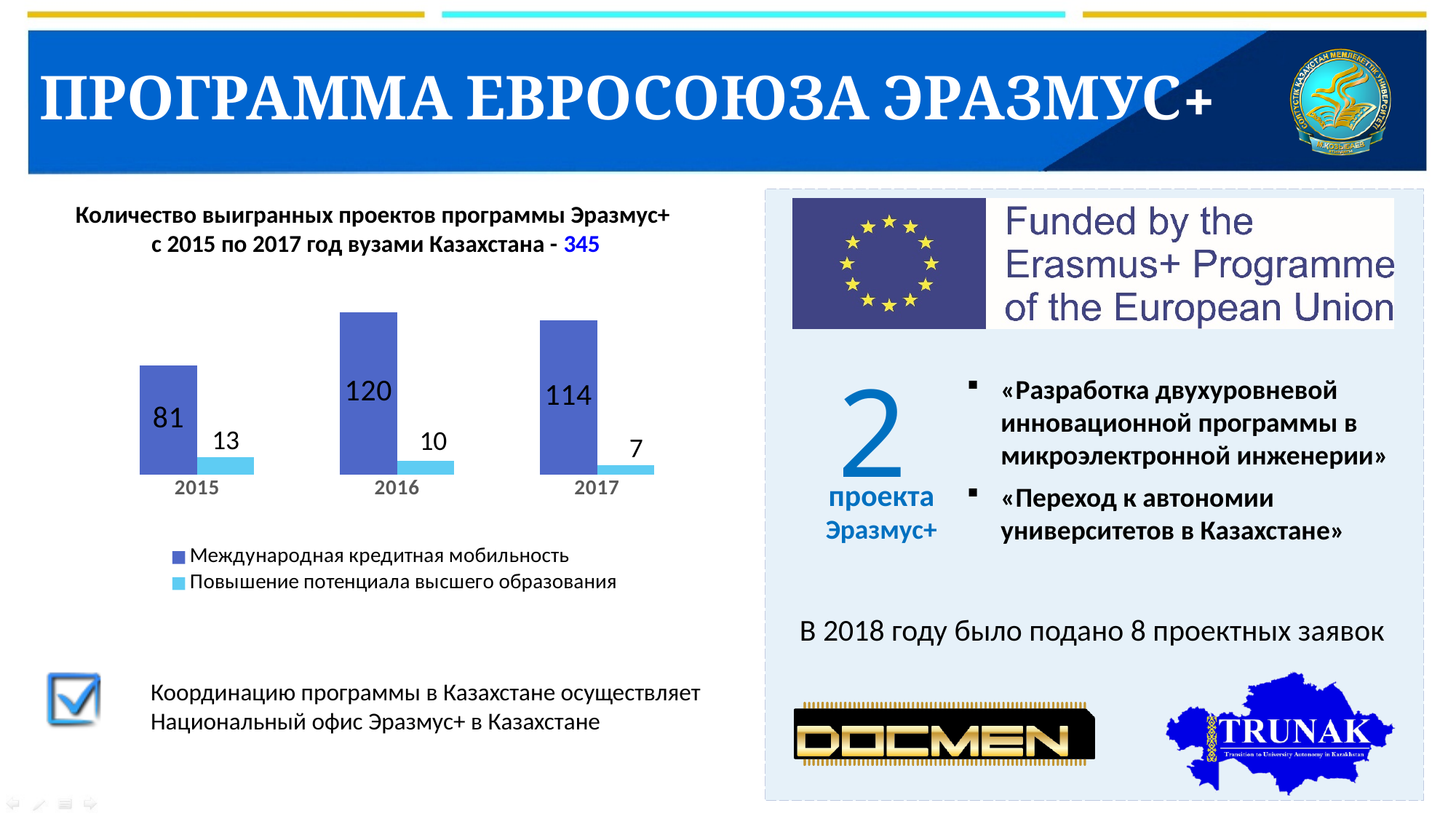
In which year is Повышение потенциала высшего образования lowest? 2017 How many series does the chart legend list? 2 What is the difference between Международная кредитная мобильность in 2016 and 2015? 39 Which is larger: Международная кредитная мобильность in 2017 or in 2015? 2017 What is the value for Международная кредитная мобильность in 2016? 120 What kind of chart is shown on the slide? bar chart Does Повышение потенциала высшего образования rise or fall from 2015 to 2017? fall What is the value for Международная кредитная мобильность in 2015? 81 How many years are shown on the x axis of the chart? 3 What is the value for Повышение потенциала высшего образования in 2015? 13 In which year is Международная кредитная мобильность highest? 2016 What is the value for Повышение потенциала высшего образования in 2017? 7